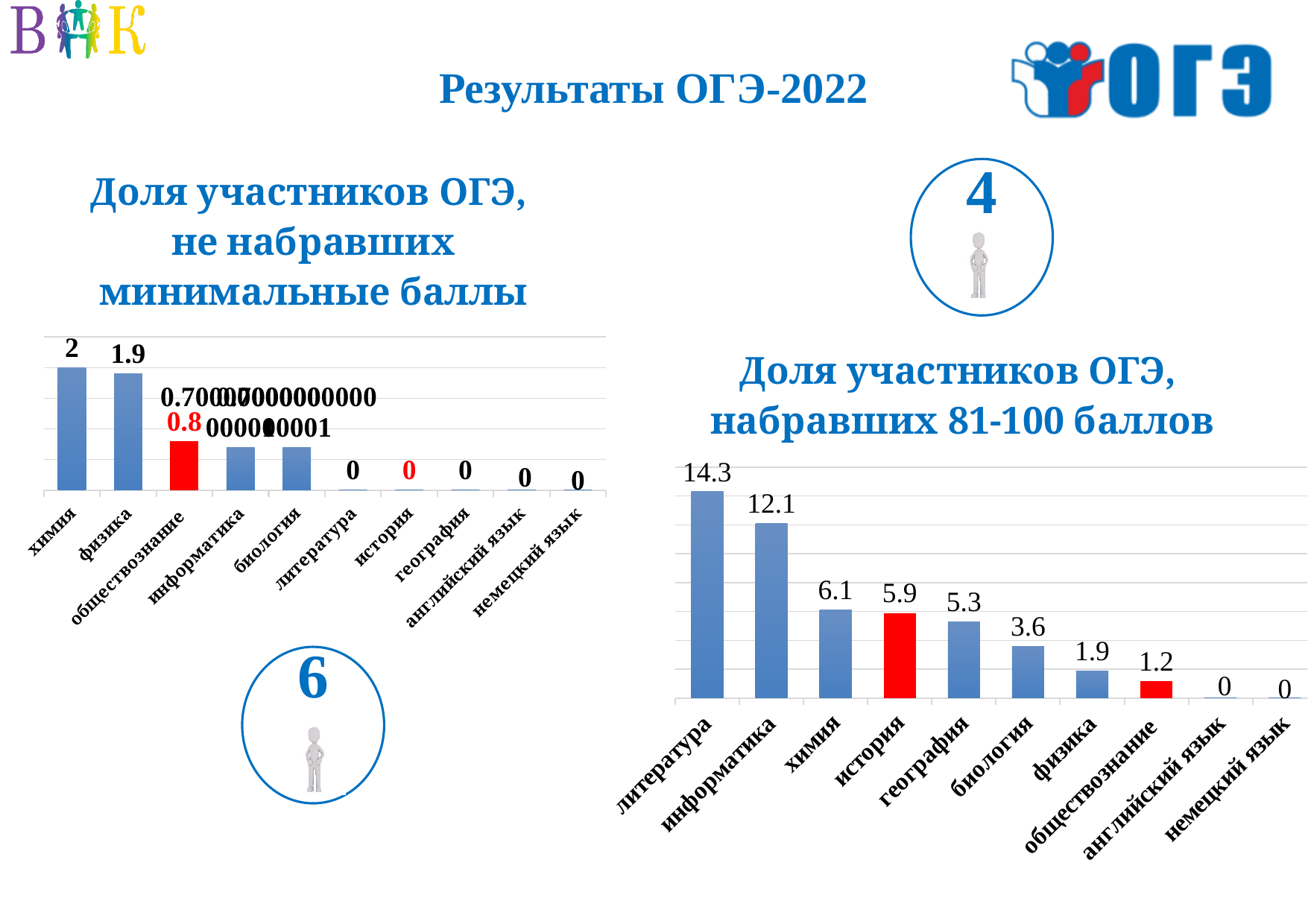
In the chart 'Доля участников ОГЭ, не набравших минимальные баллы', which category has the highest value? химия In the chart 'Доля участников ОГЭ, набравших 81-100 баллов', how many categories are shown on the x axis? 10 In the chart 'Доля участников ОГЭ, не набравших минимальные баллы', what is the value for химия? 2 In the chart 'Доля участников ОГЭ, набравших 81-100 баллов', which is larger, the value for география or the value for биология? география In the chart 'Доля участников ОГЭ, набравших 81-100 баллов', what is the difference between the values for литература and информатика? 2.2 In the chart 'Доля участников ОГЭ, набравших 81-100 баллов', what is the value for история? 5.9 In the chart 'Доля участников ОГЭ, набравших 81-100 баллов', do the values rise or fall from left to right along the x axis? fall In the chart 'Доля участников ОГЭ, не набравших минимальные баллы', what is the value for обществознание? 0.8 In the chart 'Доля участников ОГЭ, набравших 81-100 баллов', which category has the highest value? литература In the chart 'Доля участников ОГЭ, набравших 81-100 баллов', what is the value for литература? 14.3 What kind of chart is 'Доля участников ОГЭ, не набравших минимальные баллы'? bar chart In the chart 'Доля участников ОГЭ, набравших 81-100 баллов', which bars are coloured red? история and обществознание